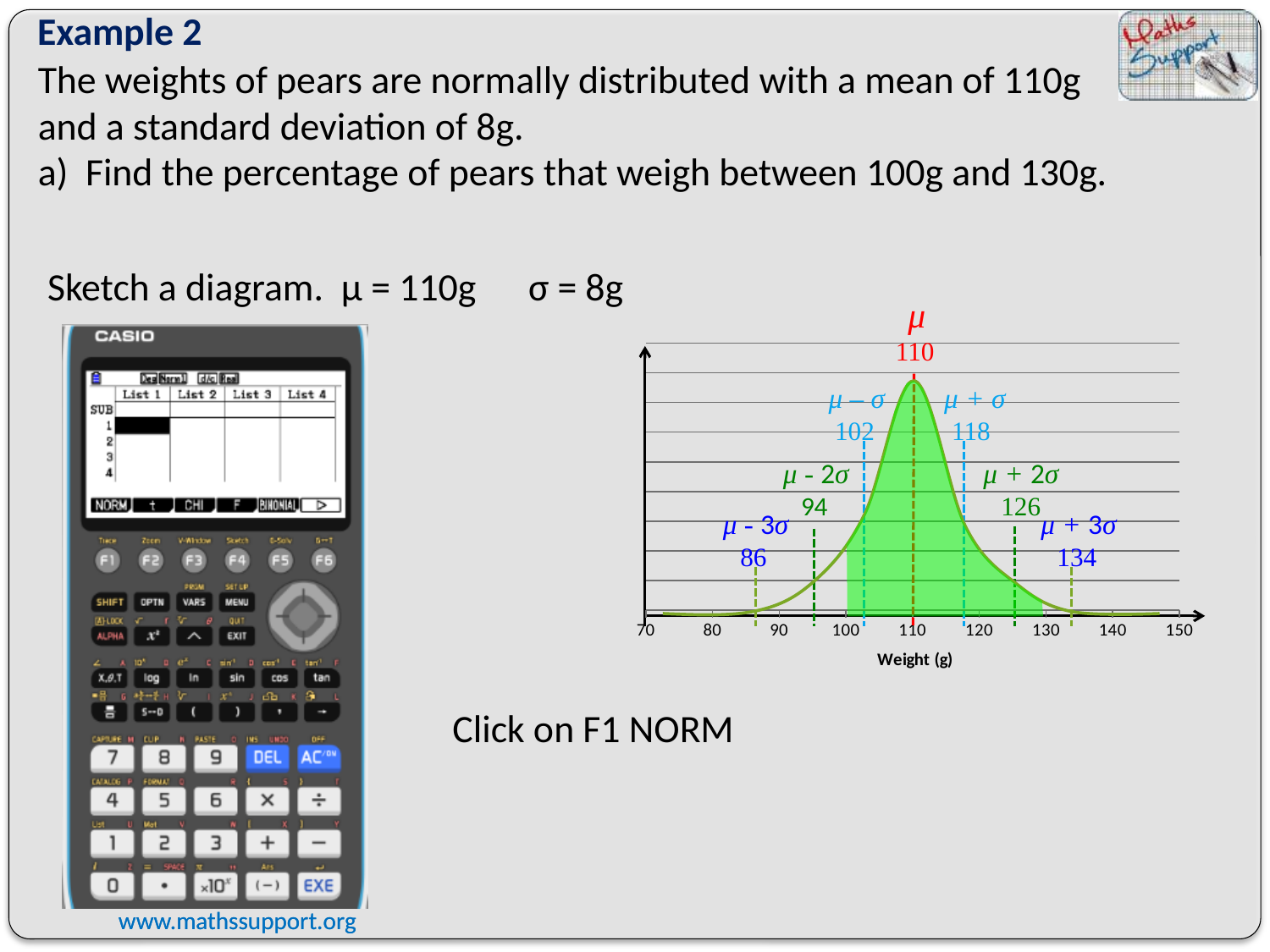
What is the x-axis title of the chart? Weight (g) What is the difference between the values labelled at μ + σ and μ − σ? 16 What value is labelled at μ − 3σ on the chart? 86 What value is labelled at μ + 3σ on the chart? 134 What value is labelled at μ + σ on the chart? 118 What value is labelled at μ + 2σ on the chart? 126 How many labelled points (μ and the σ multiples) are marked on the chart? 7 What value is labelled at μ − σ on the chart? 102 At which weight does the curve reach its peak? 110 What is the lowest value shown on the x axis of the chart? 70 What value is labelled at μ on the chart? 110 Between which two weights on the x axis is the region under the curve shaded green? 100 and 130